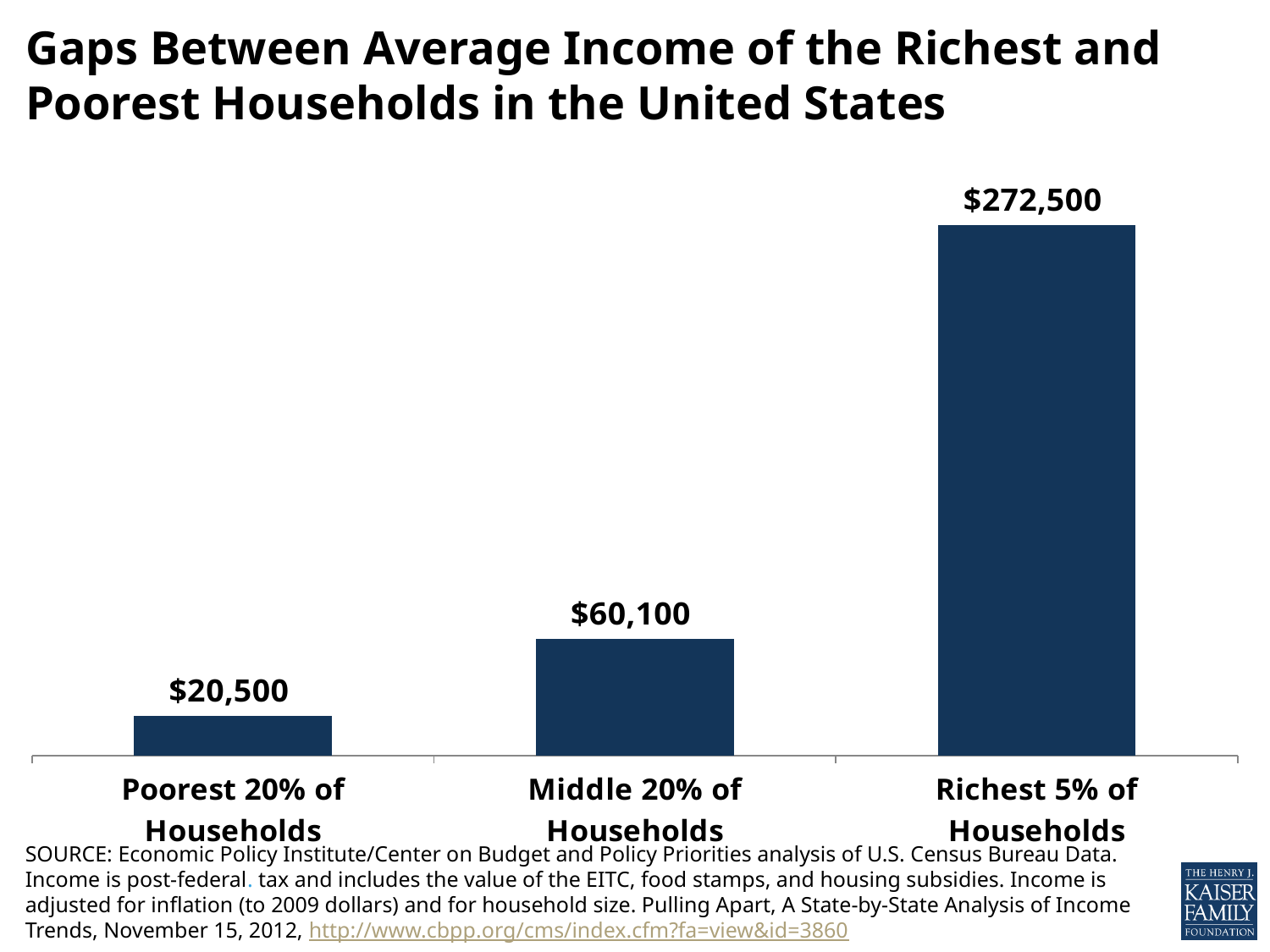
Which household group has the highest average income on the chart? Richest 5% of Households What is the average income shown for the Middle 20% of Households? $60,100 Which household group has the lowest average income on the chart? Poorest 20% of Households Do the values rise or fall moving from left to right across the chart? Rise What is the title of the chart? Gaps Between Average Income of the Richest and Poorest Households in the United States What kind of chart is shown on the slide? Bar chart What is the average income shown for the Poorest 20% of Households? $20,500 How many household groups are shown on the chart? 3 What is the difference in average income between the Middle 20% of Households and the Poorest 20% of Households? $39,600 What is the difference in average income between the Richest 5% of Households and the Poorest 20% of Households? $252,000 Which has a higher average income, the Middle 20% of Households or the Poorest 20% of Households? Middle 20% of Households What is the average income shown for the Richest 5% of Households? $272,500